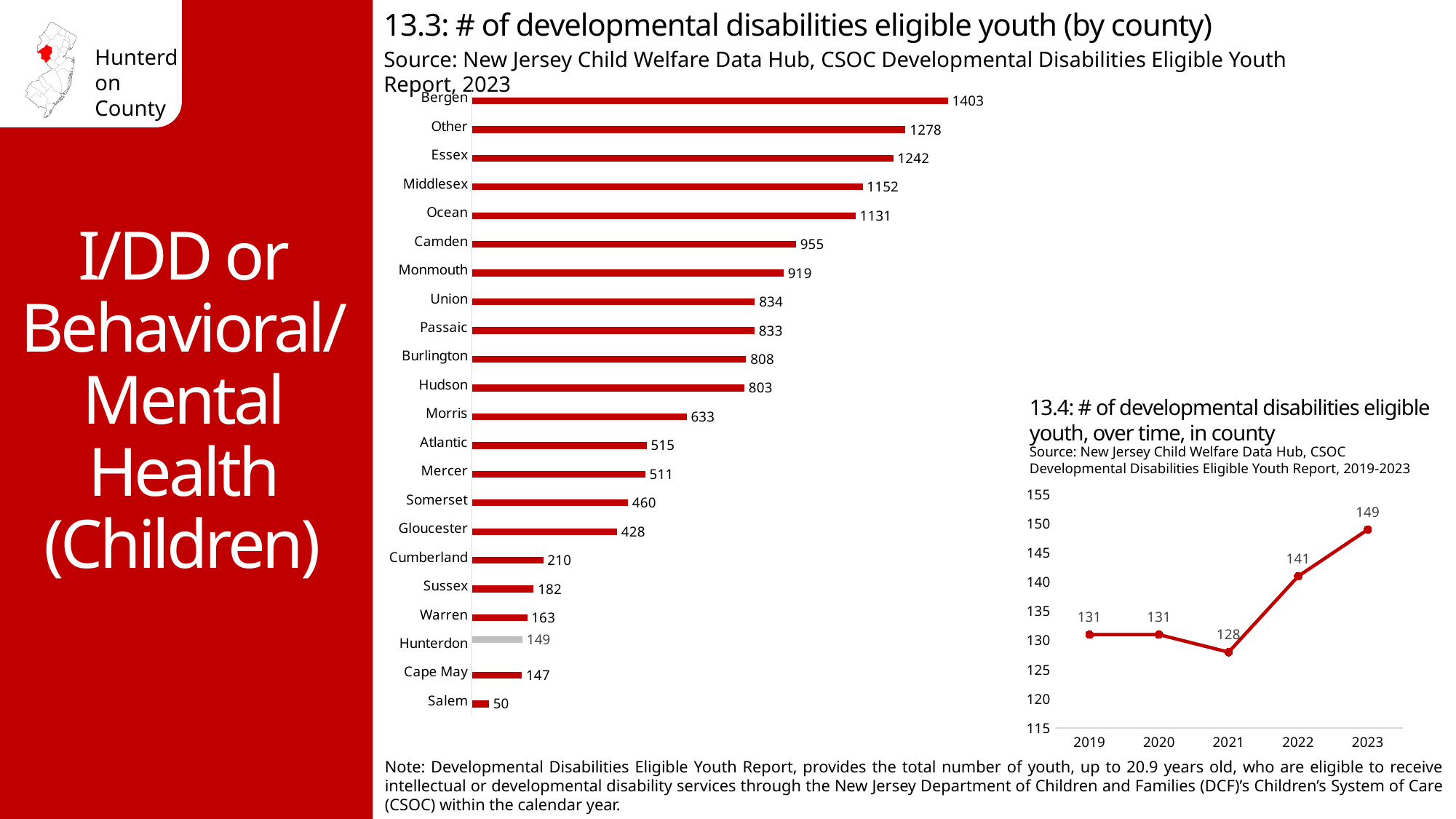
In chart 13.4 (over time, in county), what is the value for 2021? 128 In chart 13.3 (by county), which is larger, the value for Morris or the value for Atlantic? Morris In chart 13.3 (by county), how many bars (categories) are shown? 22 In chart 13.3 (by county), which county has the highest number of developmental disabilities eligible youth? Bergen In chart 13.4 (over time, in county), how many data points are plotted? 5 In chart 13.4 (over time, in county), what is the difference between the 2023 value and the 2022 value? 8 In chart 13.3 (by county), what is the value for Camden? 955 In chart 13.3 (# of developmental disabilities eligible youth by county), what is the value for Hunterdon? 149 In chart 13.4 (over time, in county), which year has the highest value? 2023 In chart 13.3 (by county), what is the difference between Bergen and Essex? 161 In chart 13.3 (by county), which county has the lowest number of developmental disabilities eligible youth? Salem What type of chart is chart 13.3 (# of developmental disabilities eligible youth by county)? Bar chart